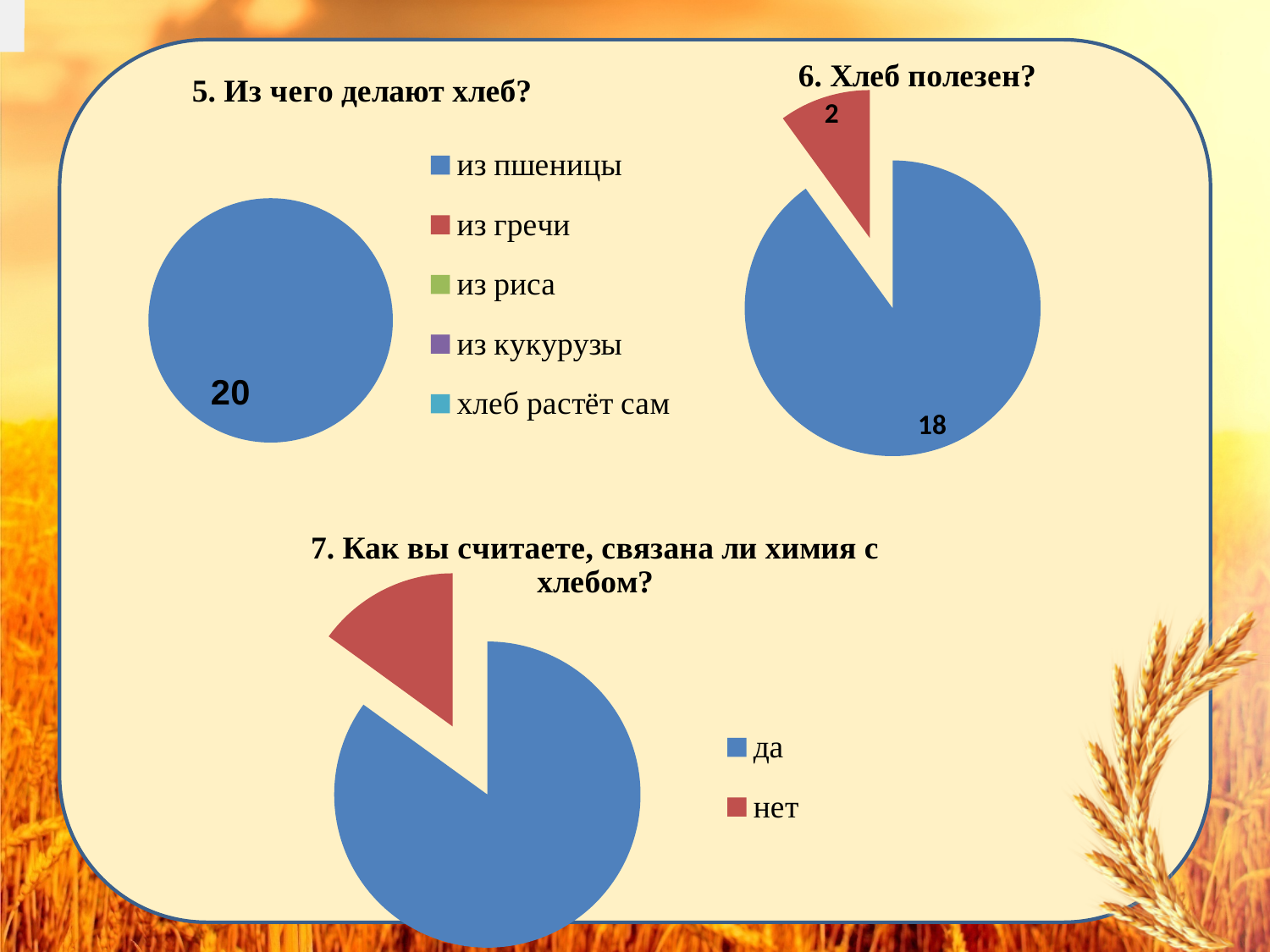
In the chart "7. Как вы считаете, связана ли химия с хлебом?", which category has the larger slice, "да" or "нет"? да In the chart "5. Из чего делают хлеб?", what value is shown for "из пшеницы"? 20 In the chart "6. Хлеб полезен?", what share of the pie does the red slice represent? 10% In the chart "6. Хлеб полезен?", what value is shown on the red slice? 2 In the chart "6. Хлеб полезен?", which slice is larger, the blue one or the red one? the blue one In the chart "6. Хлеб полезен?", what value is shown on the blue slice? 18 What kind of chart is used for "5. Из чего делают хлеб?"? pie chart In the chart "5. Из чего делают хлеб?", which legend entry is shown in blue? из пшеницы How many entries does the legend of the chart "5. Из чего делают хлеб?" list? 5 In the chart "6. Хлеб полезен?", what is the total of the two slices? 20 How many entries does the legend of the chart "7. Как вы считаете, связана ли химия с хлебом?" list? 2 In the chart "6. Хлеб полезен?", what is the difference between the blue slice and the red slice? 16